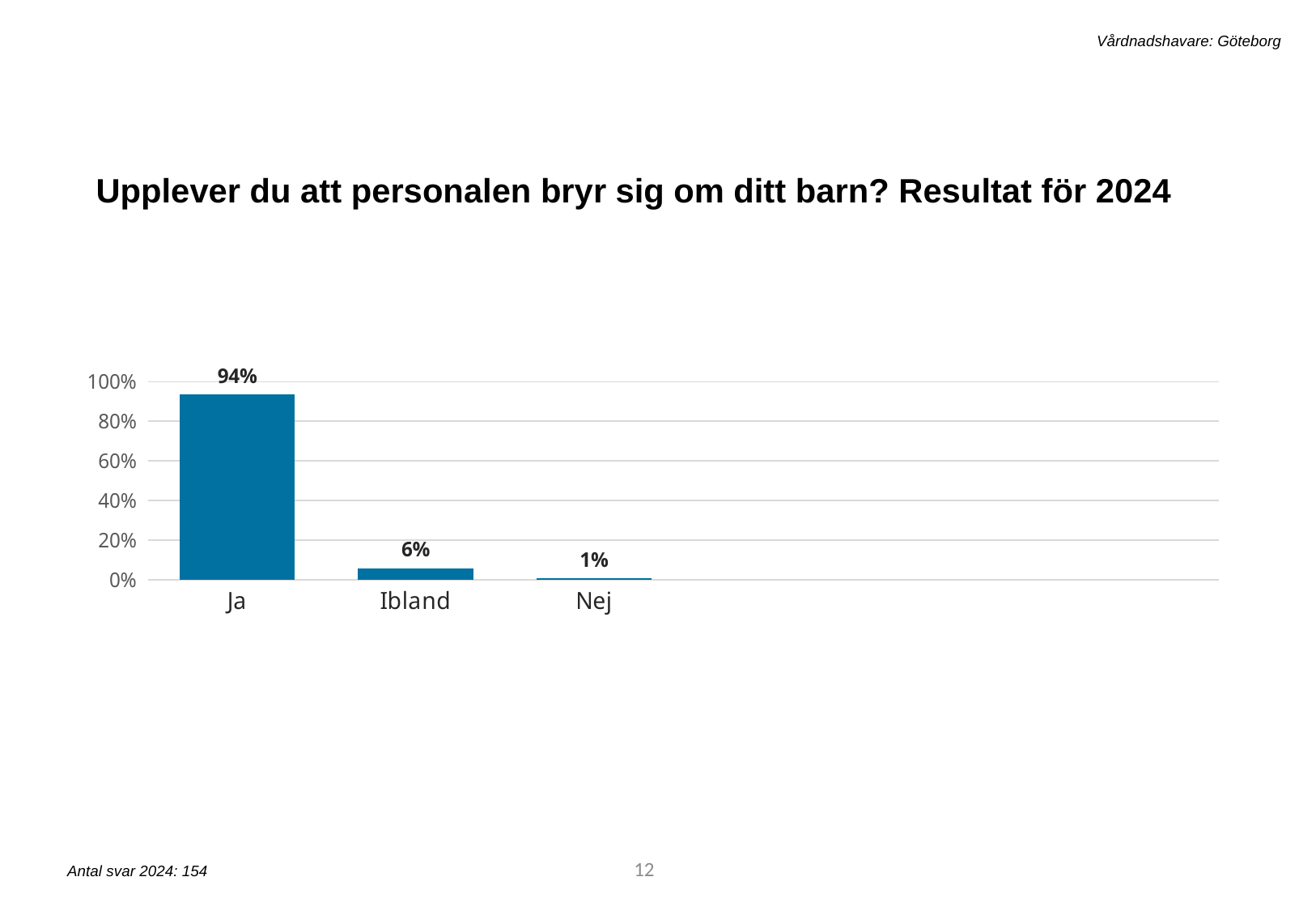
What is the value for Ibland? 6% What is the difference between the values for Ja and Ibland? 88% What kind of chart is shown on the slide? bar chart Which category has the highest value? Ja How many categories are shown on the x axis? 3 What is the value for Ja? 94% Which is larger, the value for Ibland or the value for Nej? Ibland Is the value for Ja greater or less than 80%? greater What is the difference between the values for Ibland and Nej? 5% Do the values rise or fall from left to right along the x axis? fall Which category has the lowest value? Nej What is the value for Nej? 1%